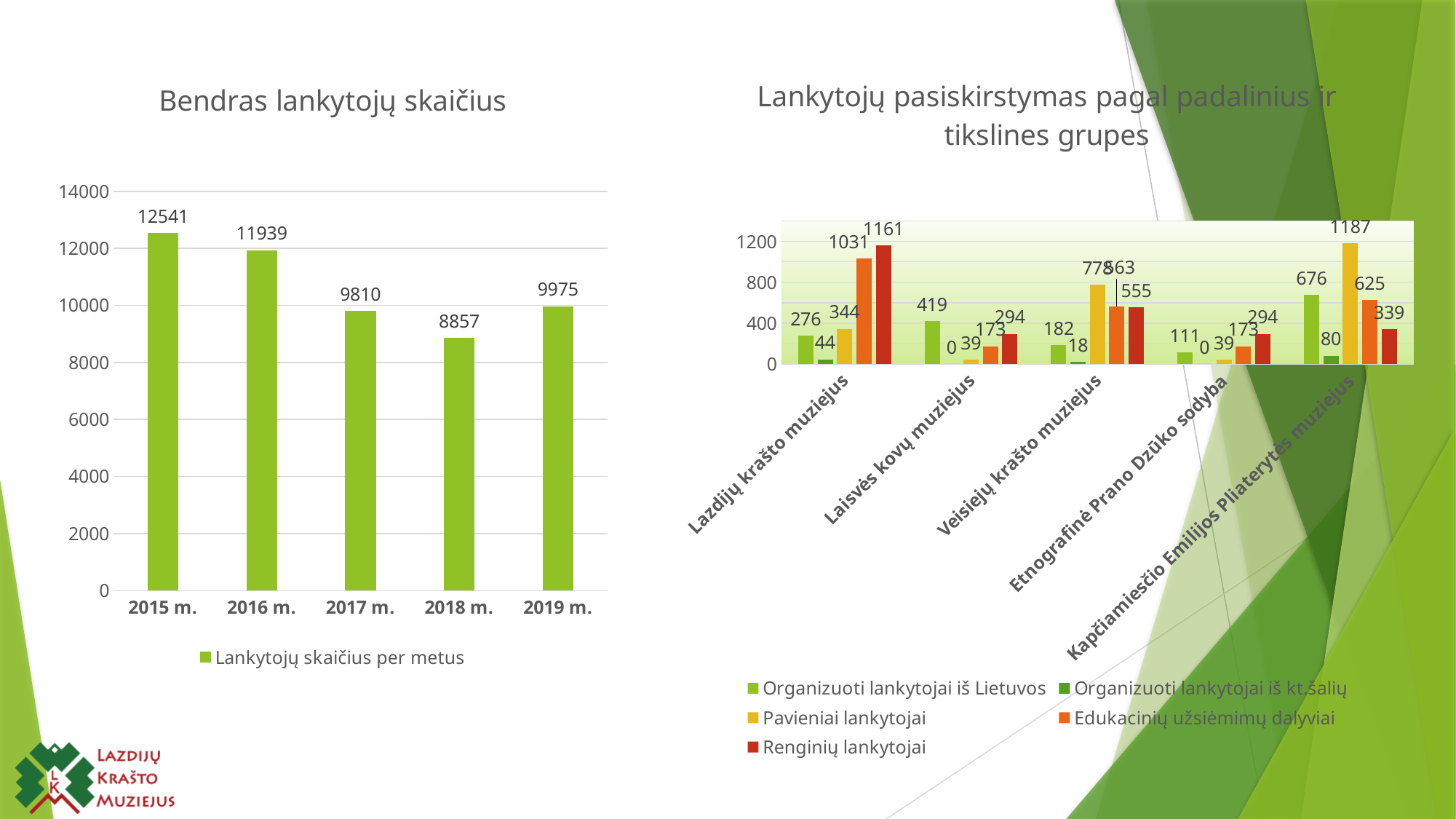
In the chart titled "Bendras lankytojų skaičius", how many years are shown on the x axis? 5 In the chart titled "Lankytojų pasiskirstymas pagal padalinius ir tikslines grupes", how many series does the legend list? 5 In the chart titled "Bendras lankytojų skaičius", what is the difference between the values for 2016 m. and 2017 m.? 2129 In the chart titled "Bendras lankytojų skaičius", what is the value for 2015 m.? 12541 In the chart titled "Lankytojų pasiskirstymas pagal padalinius ir tikslines grupes", which is larger for Laisvės kovų muziejus: Organizuoti lankytojai iš Lietuvos or Renginių lankytojai? Organizuoti lankytojai iš Lietuvos In the chart titled "Lankytojų pasiskirstymas pagal padalinius ir tikslines grupes", what is the value of Organizuoti lankytojai iš kt.šalių for Veisiejų krašto muziejus? 18 In the chart titled "Lankytojų pasiskirstymas pagal padalinius ir tikslines grupes", what is the value of Pavieniai lankytojai for Kapčiamiesčio Emilijos Pliaterytės muziejus? 1187 In the chart titled "Bendras lankytojų skaičius", which year has the lowest value? 2018 m. In the chart titled "Bendras lankytojų skaičius", what kind of chart is it? bar chart In the chart titled "Bendras lankytojų skaičius", which year has the highest value? 2015 m. In the chart titled "Bendras lankytojų skaičius", is the value for 2019 m. greater or less than 10000? less In the chart titled "Lankytojų pasiskirstymas pagal padalinius ir tikslines grupes", what is the value of Renginių lankytojai for Lazdijų krašto muziejus? 1161